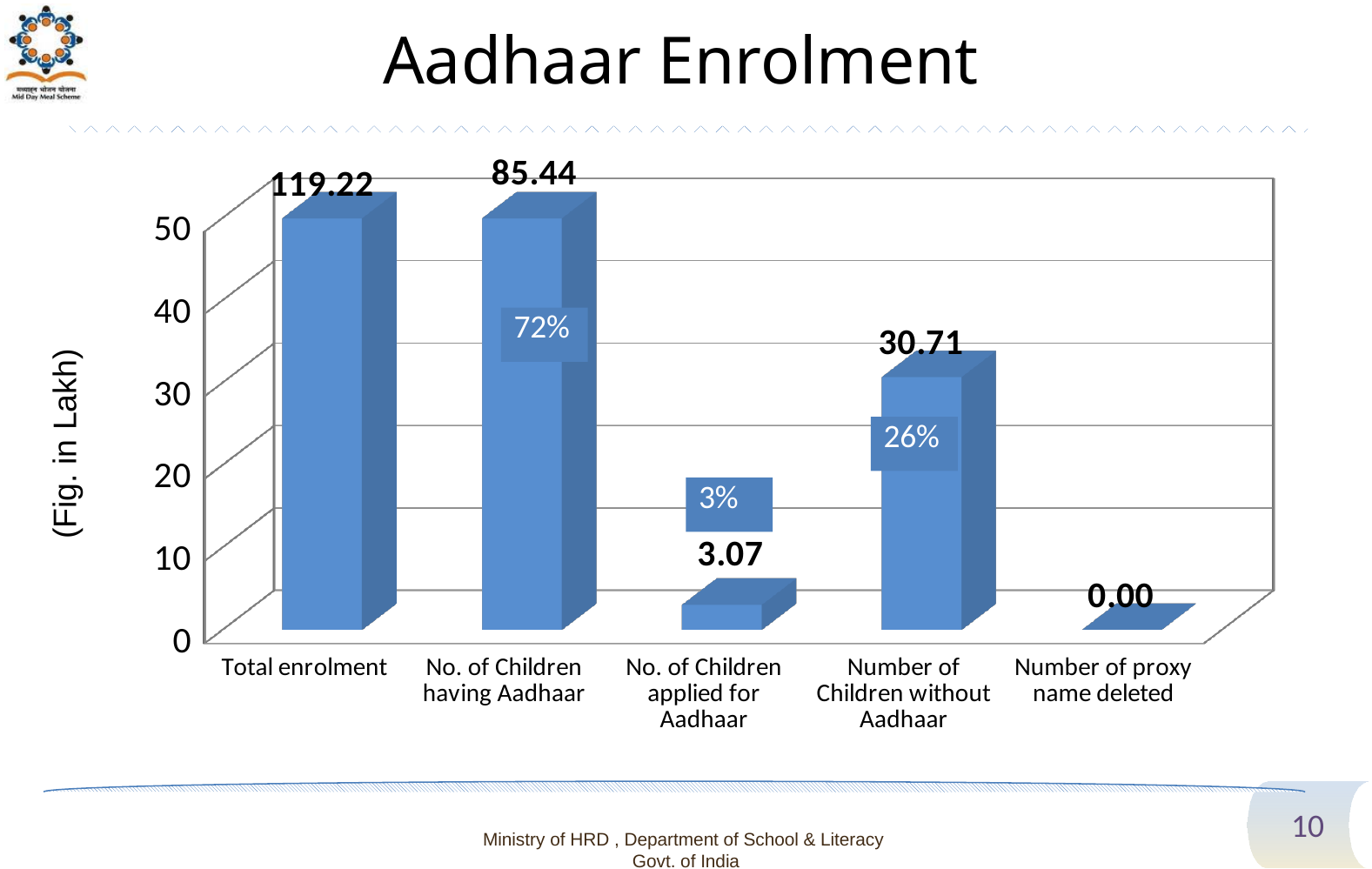
Which category has the highest value? Total enrolment What percentage label is shown on the bar for No. of Children having Aadhaar? 72% Which category has the lowest value? Number of proxy name deleted How many categories are shown on the x axis? 5 What is the value for Total enrolment? 119.22 What is the value for Number of proxy name deleted? 0.00 What kind of chart is this? Bar chart What is the value for Number of Children without Aadhaar? 30.71 What is the value for No. of Children having Aadhaar? 85.44 Which is larger, the value for Number of Children without Aadhaar or the value for No. of Children applied for Aadhaar? Number of Children without Aadhaar What is the difference between the values for No. of Children having Aadhaar and Number of Children without Aadhaar? 54.73 What is the value for No. of Children applied for Aadhaar? 3.07